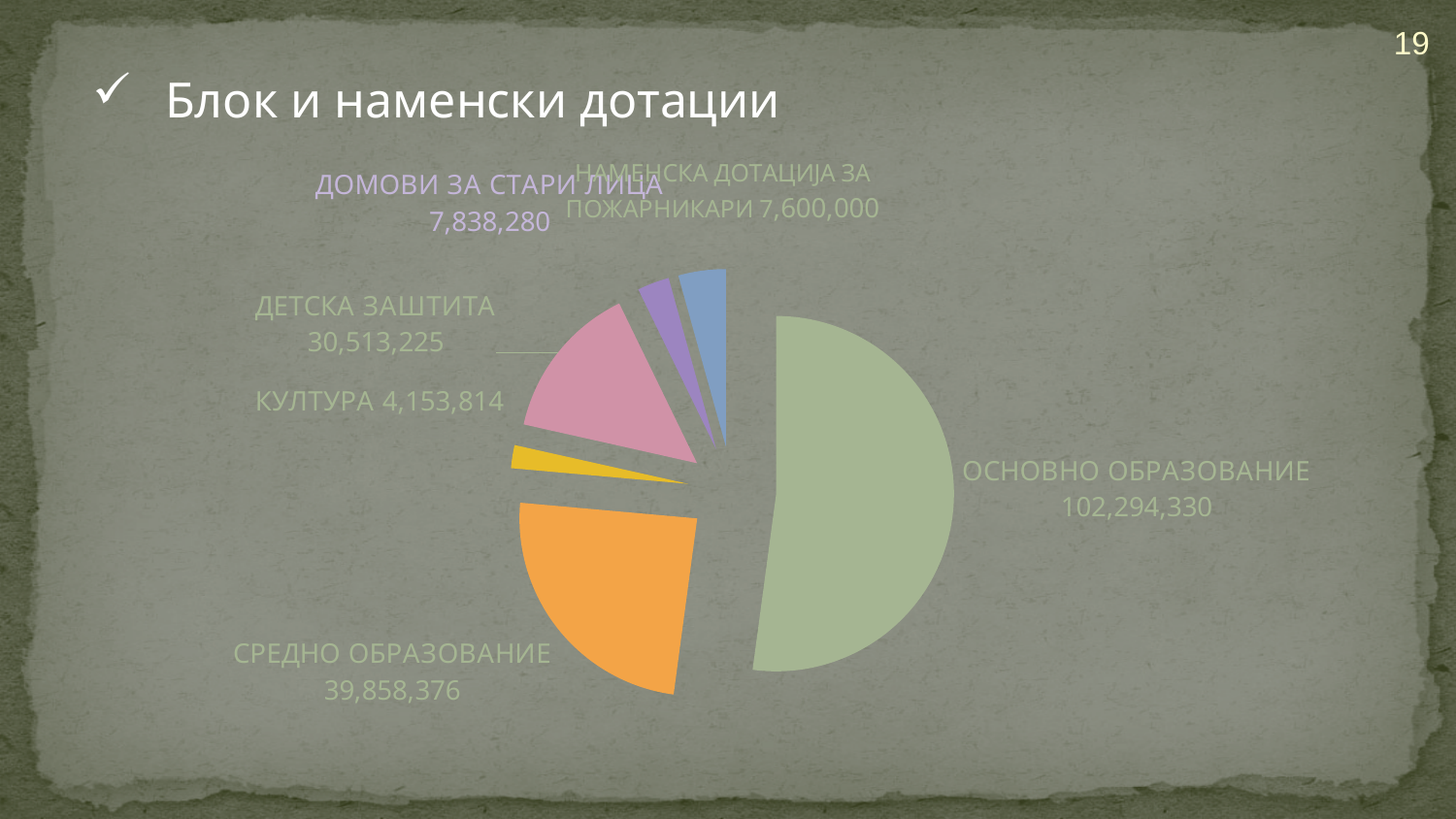
What is the value for КУЛТУРА? 4,153,814 What is the title of the slide containing the chart? Блок и наменски дотации Which category has the largest slice of the pie? ОСНОВНО ОБРАЗОВАНИЕ What is the value for НАМЕНСКА ДОТАЦИЈА ЗА ПОЖАРНИКАРИ? 7,600,000 What type of chart is shown on the slide? pie chart How many categories are shown in the pie chart? 6 Which is larger, ДОМОВИ ЗА СТАРИ ЛИЦА or НАМЕНСКА ДОТАЦИЈА ЗА ПОЖАРНИКАРИ? ДОМОВИ ЗА СТАРИ ЛИЦА Which category has the smallest slice of the pie? КУЛТУРА What is the value for СРЕДНО ОБРАЗОВАНИЕ? 39,858,376 What is the value for ОСНОВНО ОБРАЗОВАНИЕ? 102,294,330 What is the difference between ОСНОВНО ОБРАЗОВАНИЕ and СРЕДНО ОБРАЗОВАНИЕ? 62,435,954 What is the value for ДЕТСКА ЗАШТИТА? 30,513,225